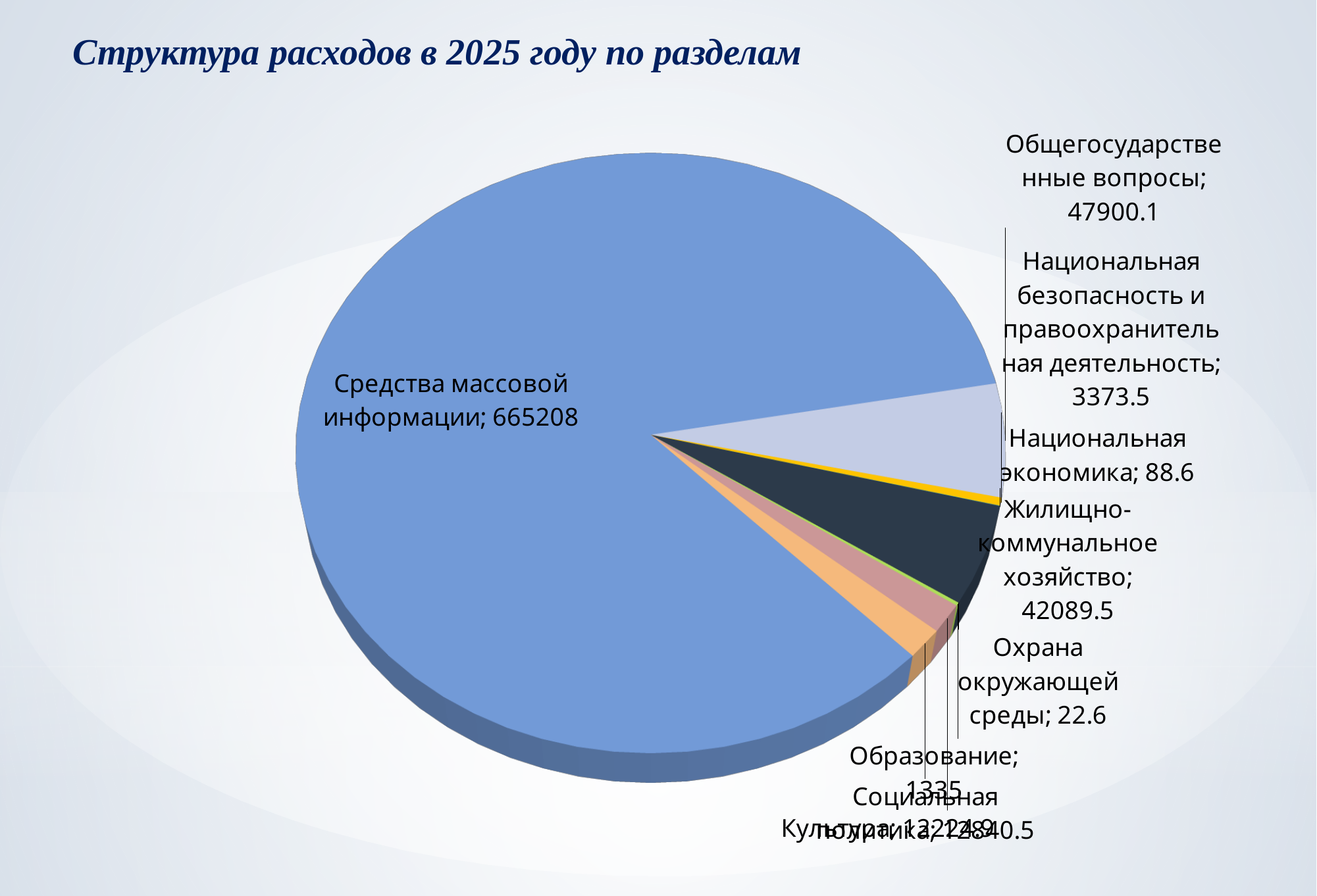
Which is larger: the value for Национальная экономика or the value for Образование? Образование What is the difference between the values for Общегосударственные вопросы and Жилищно-коммунальное хозяйство? 5810.6 What is the value for Охрана окружающей среды? 22.6 What is the value for Образование? 1335 Which category has the largest slice of the pie? Средства массовой информации What is the value for Общегосударственные вопросы? 47900.1 What is the title of the chart? Структура расходов в 2025 году по разделам What is the value for Средства массовой информации? 665208 What is the value for Жилищно-коммунальное хозяйство? 42089.5 What is the value for Национальная безопасность и правоохранительная деятельность? 3373.5 What kind of chart is shown on the slide? pie chart Which category has the smallest slice of the pie? Охрана окружающей среды